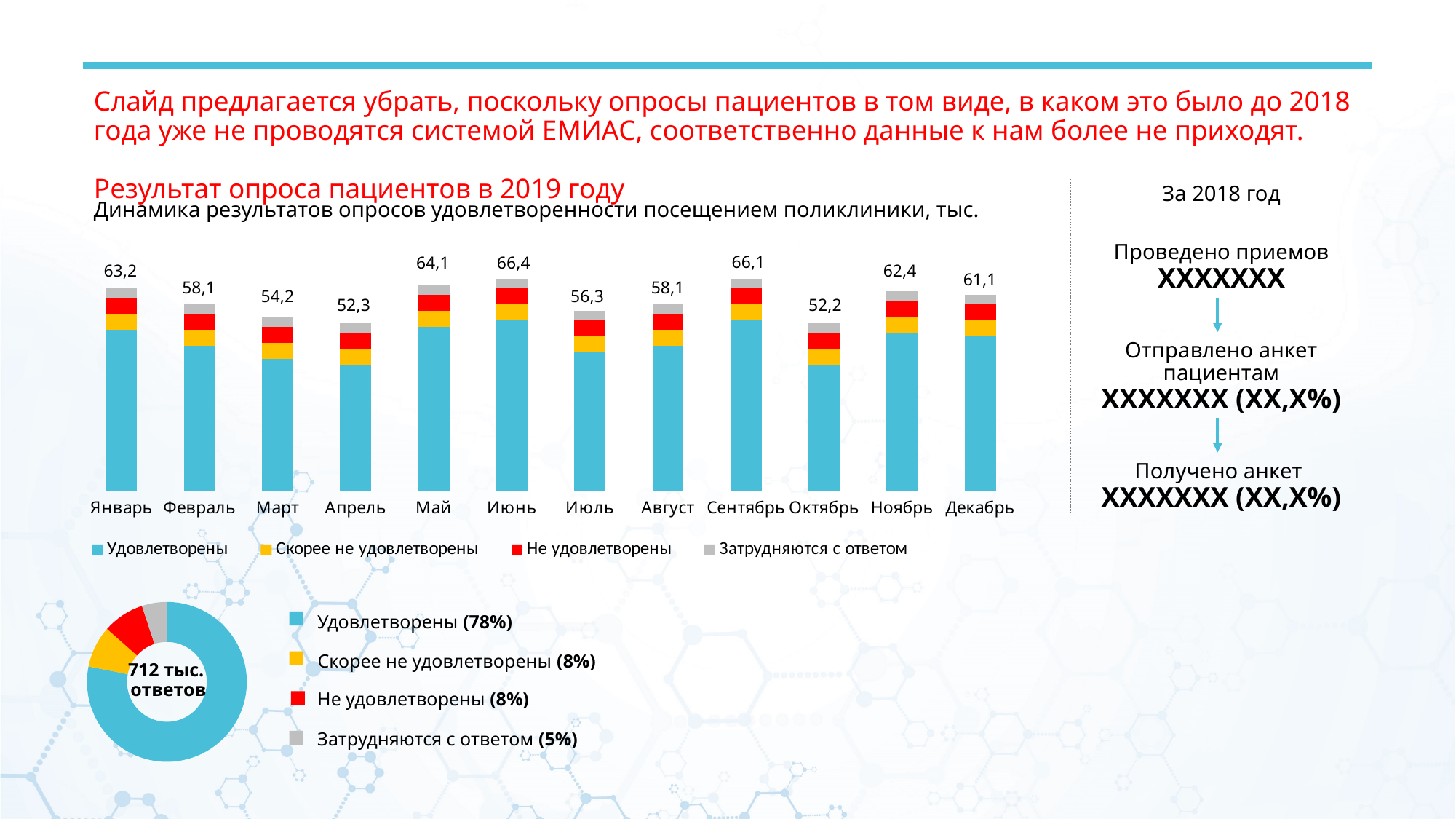
In the stacked bar chart, which month has the lowest total? Октябрь In the donut chart, what share is labeled for Удовлетворены? 78% In the stacked bar chart, which month has a larger total, Сентябрь or Ноябрь? Сентябрь In the donut chart, what share is labeled for Затрудняются с ответом? 5% In the stacked bar chart, what is the total value labeled for Июнь? 66,4 What type of chart is the monthly chart at the top of the slide? Stacked bar chart How many months are shown on the x axis of the stacked bar chart? 12 How many series does the legend of the stacked bar chart list? 4 What text is shown in the center of the donut chart? 712 тыс. ответов In the stacked bar chart, what is the difference between the totals for Июнь and Октябрь? 14,2 In the stacked bar chart, what is the total value labeled for Апрель? 52,3 In the stacked bar chart, which month has the highest total? Июнь